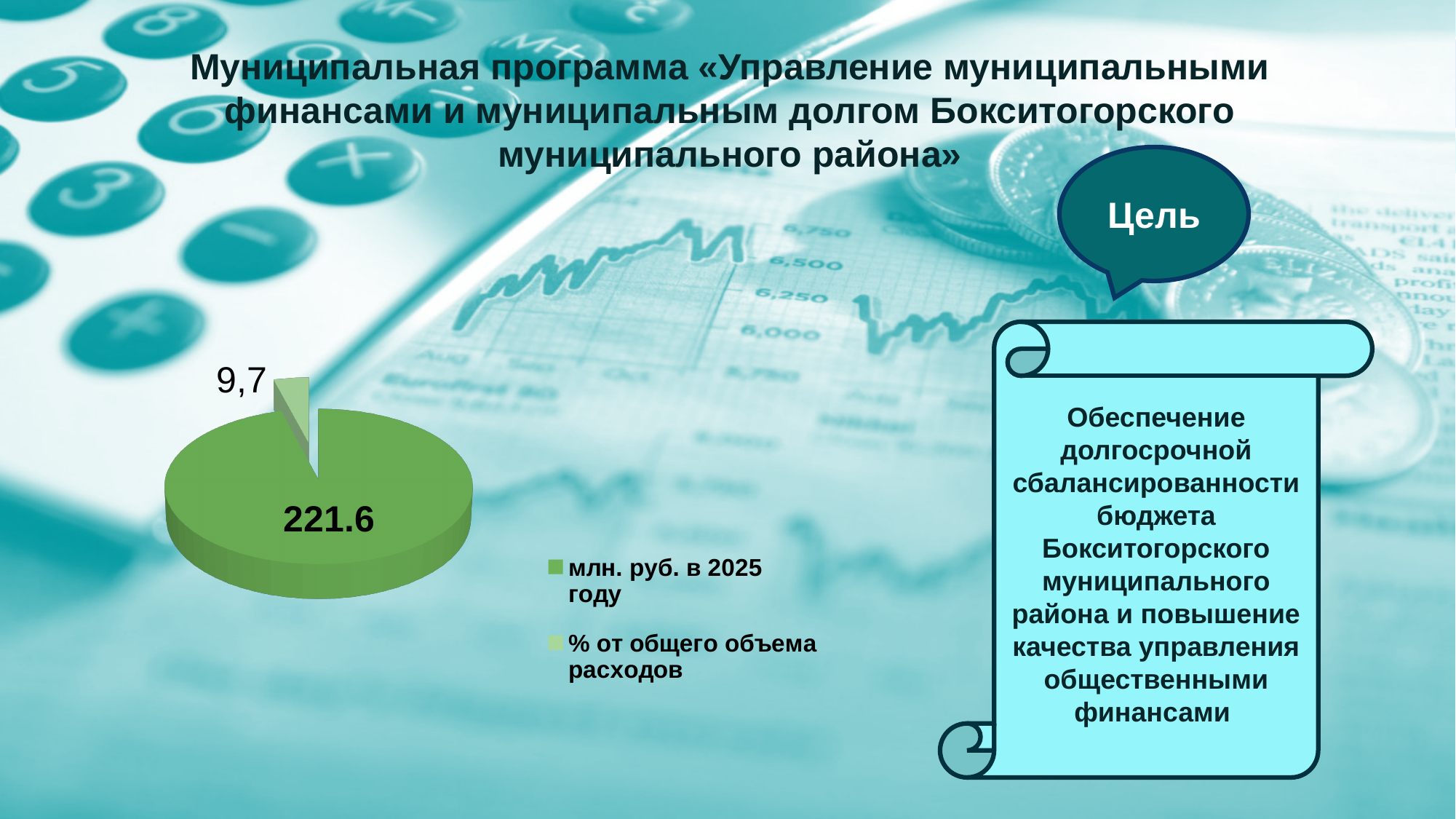
How many entries does the chart legend list? 2 Which is larger: the value for "млн. руб. в 2025 году" or the value for "% от общего объема расходов"? млн. руб. в 2025 году What kind of chart is shown on the slide? pie chart What value is shown for the slice labelled "% от общего объема расходов"? 9,7 Which slice of the pie chart is the largest? млн. руб. в 2025 году What is the first entry listed in the chart legend? млн. руб. в 2025 году Which slice of the pie chart is the smallest? % от общего объема расходов How many slices does the pie chart have? 2 What colour is the slice labelled "млн. руб. в 2025 году"? dark green What value is shown for the slice labelled "млн. руб. в 2025 году"? 221.6